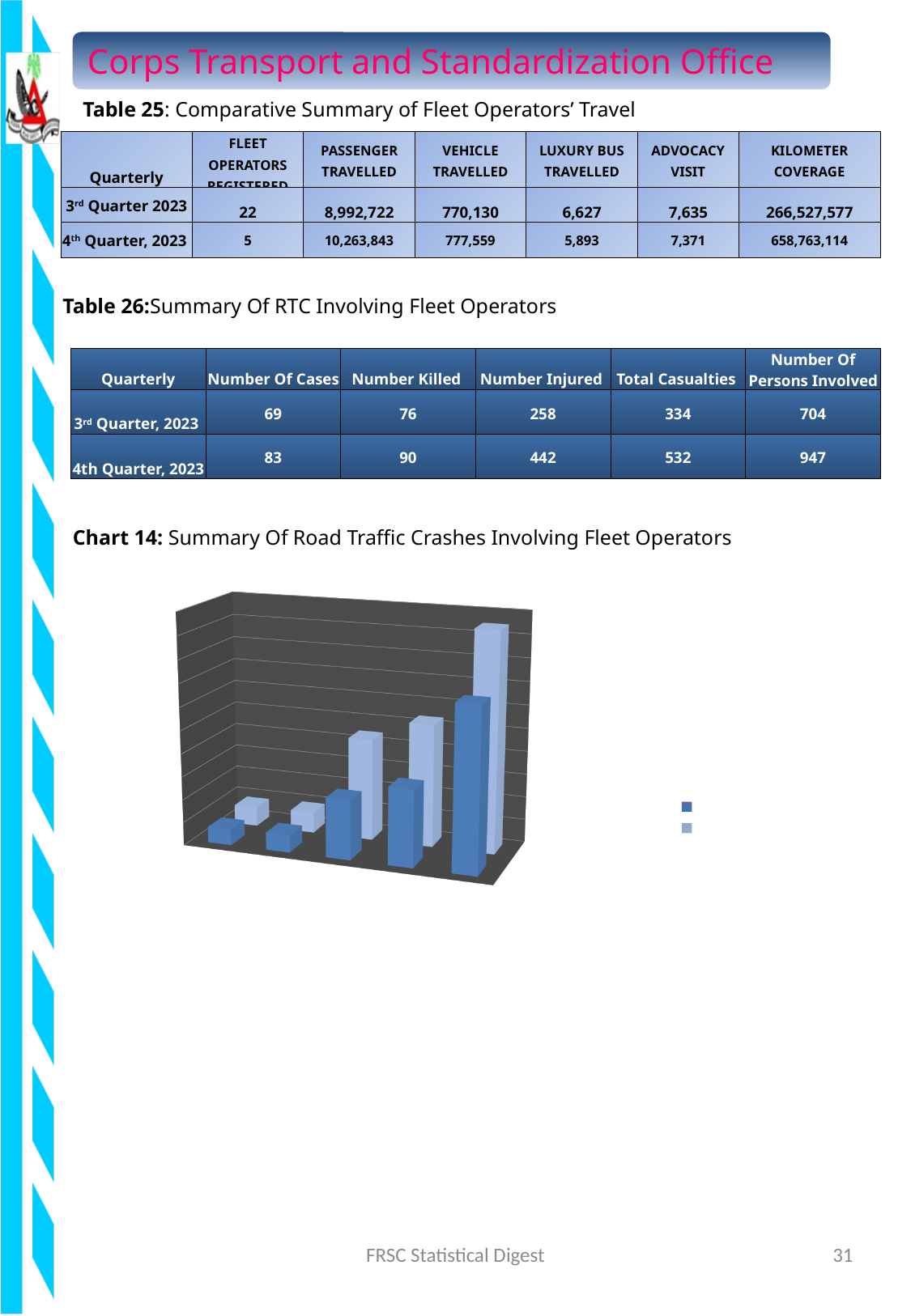
How many groups of bars are plotted in Chart 14? 5 In Chart 14, is the tallest bar in the leftmost or the rightmost group? rightmost What kind of chart is Chart 14? bar chart In Chart 14, do the bar heights generally rise or fall from left to right? rise How many series does the legend of Chart 14 list? 2 What is the title of Chart 14? Summary Of Road Traffic Crashes Involving Fleet Operators